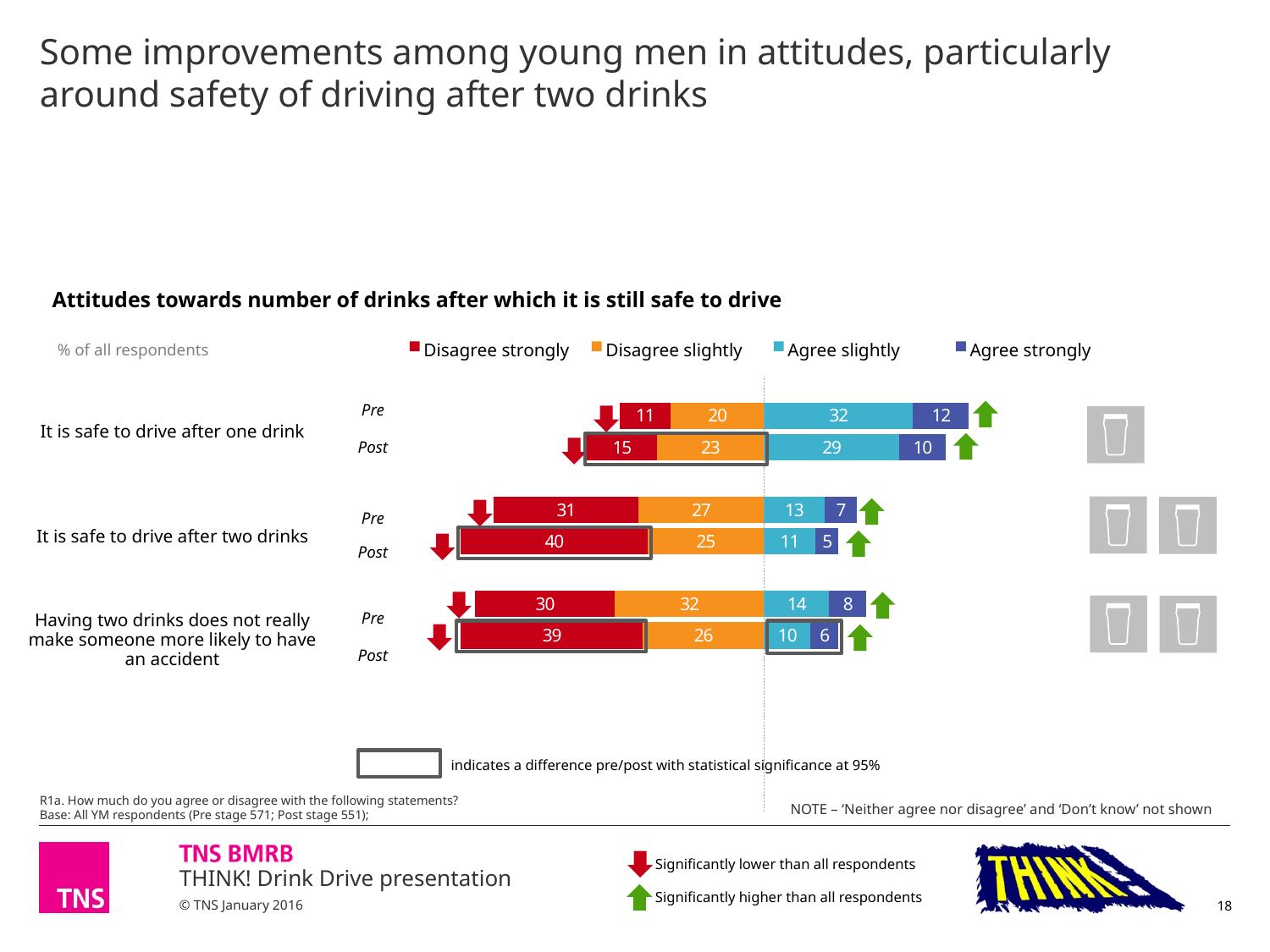
What is the total of the Pre bar for 'It is safe to drive after one drink' (sum of all four segments)? 75 How many series does the chart legend list? 4 What is the difference between the Post and Pre 'Disagree strongly' values for 'It is safe to drive after two drinks'? 9 Which is larger: the 'Agree slightly' value for the Pre bar or the Post bar of 'It is safe to drive after one drink'? Pre What is the 'Disagree slightly' value for the Post bar of 'Having two drinks does not really make someone more likely to have an accident'? 26 Which bar has the lowest 'Agree strongly' value? It is safe to drive after two drinks (Post) Which statement has the highest 'Disagree strongly' value across all bars? It is safe to drive after two drinks (Post) What is the 'Agree slightly' value for the Pre bar of 'It is safe to drive after one drink'? 32 What is the 'Agree strongly' value for the Pre bar of 'Having two drinks does not really make someone more likely to have an accident'? 8 What type of chart is shown on the slide? Stacked bar chart What is the 'Disagree strongly' value for the Post bar of 'It is safe to drive after two drinks'? 40 What is the title of the chart? Attitudes towards number of drinks after which it is still safe to drive